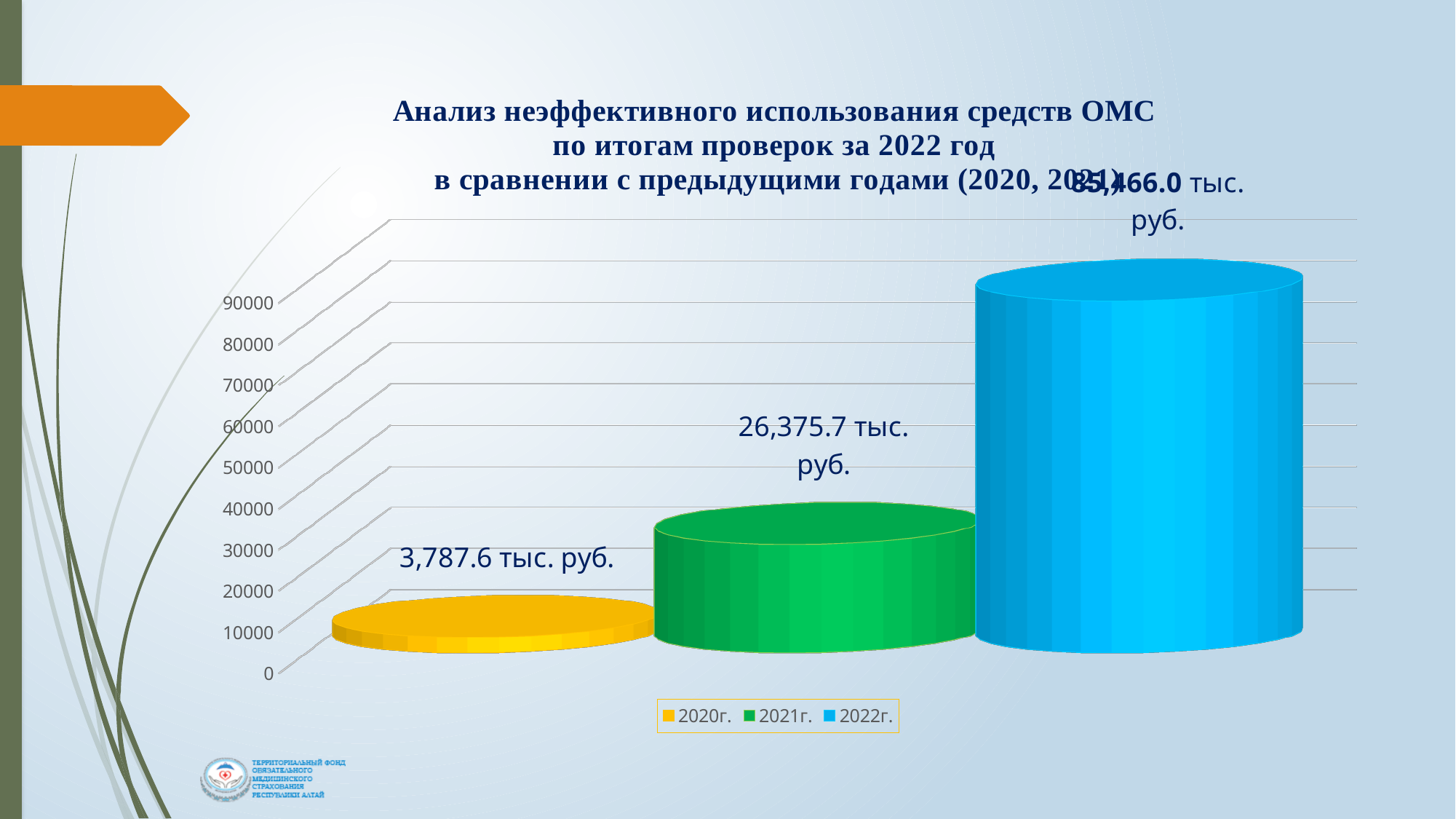
What is the value for 2020г.? 3,787.6 тыс. руб. Is the value for 2021г. greater or less than 40000? less Is the value for 2022г. greater or less than 50000? greater Do the values rise or fall from 2020г. to 2022г.? Rise Which year has the lowest value? 2020г. Which year has the highest value? 2022г. What colour is the bar for 2022г.? Blue What is the value for 2021г.? 26,375.7 тыс. руб. Which is larger, the value for 2021г. or the value for 2020г.? 2021г. What is the difference between the values for 2021г. and 2020г.? 22,588.1 тыс. руб. What kind of chart is shown on the slide? Bar chart How many series does the legend list? 3